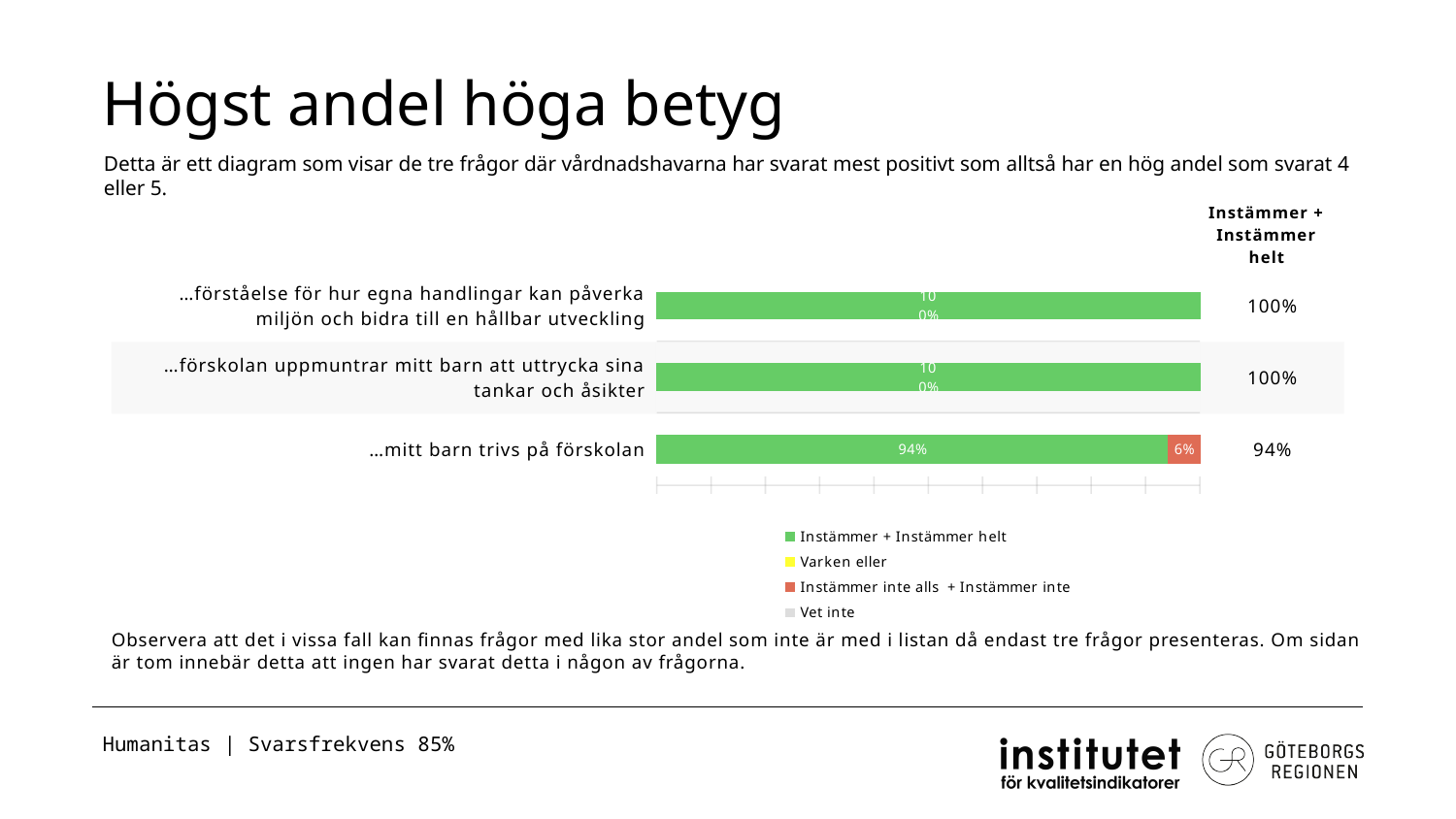
How many categories (questions) are plotted in the chart? 3 What is the 'Instämmer + Instämmer helt' value for '…förståelse för hur egna handlingar kan påverka miljön och bidra till en hållbar utveckling'? 100% What kind of chart is shown on the slide? bar chart What is the difference in 'Instämmer + Instämmer helt' share between '…förskolan uppmuntrar mitt barn att uttrycka sina tankar och åsikter' and '…mitt barn trivs på förskolan'? 6 percentage points How many series does the legend list? 4 What is the 'Instämmer + Instämmer helt' value for '…mitt barn trivs på förskolan'? 94% What is the 'Instämmer + Instämmer helt' value for '…förskolan uppmuntrar mitt barn att uttrycka sina tankar och åsikter'? 100% What is the 'Instämmer inte alls + Instämmer inte' value for '…mitt barn trivs på förskolan'? 6% Which legend entry is shown in green? Instämmer + Instämmer helt Which category has the lowest 'Instämmer + Instämmer helt' share? …mitt barn trivs på förskolan Which is larger: the 'Instämmer + Instämmer helt' share for '…mitt barn trivs på förskolan' or for '…förståelse för hur egna handlingar kan påverka miljön och bidra till en hållbar utveckling'? …förståelse för hur egna handlingar kan påverka miljön och bidra till en hållbar utveckling What is the total of the stacked bar for '…mitt barn trivs på förskolan'? 100%